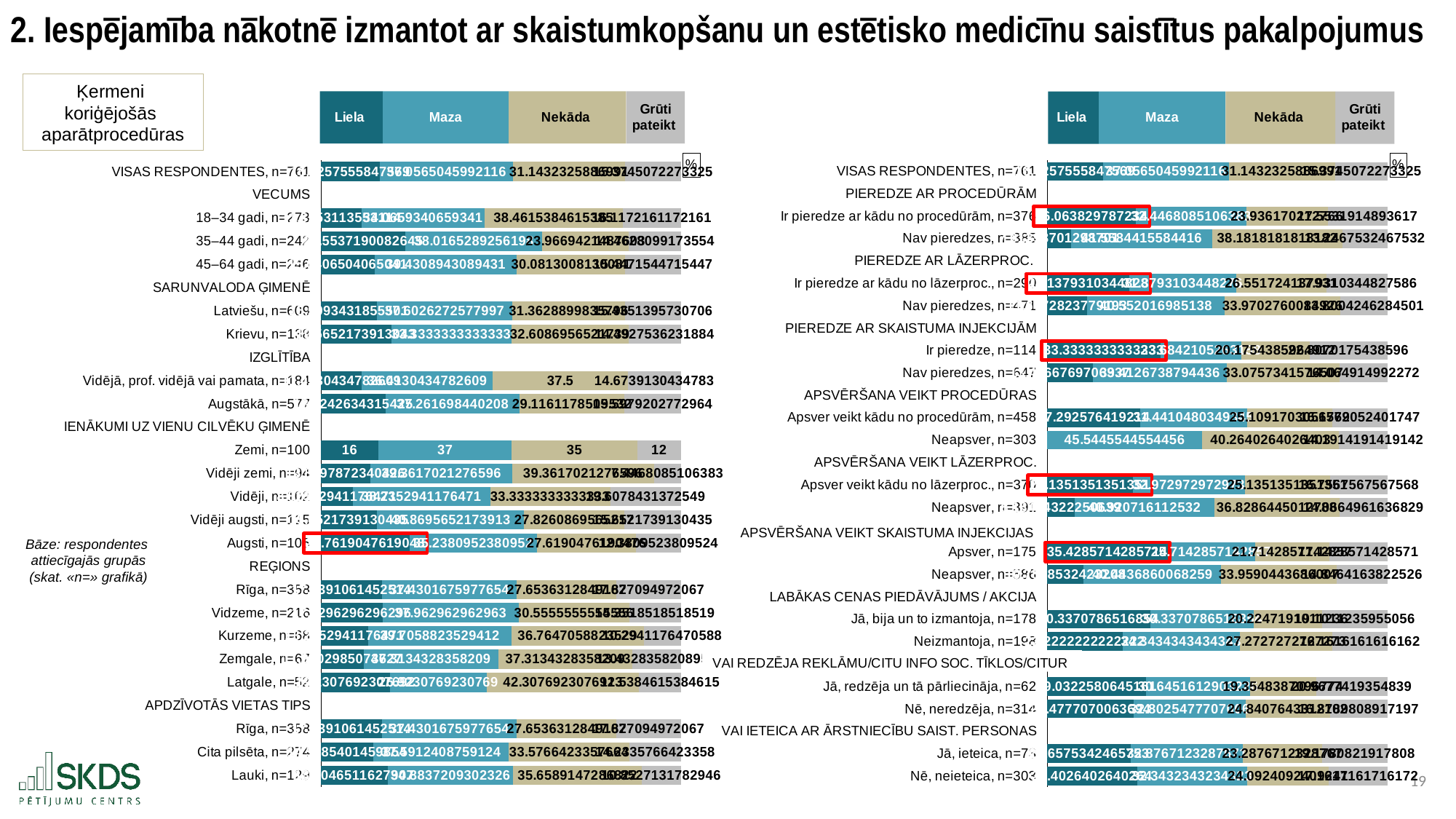
What are the four legend entries of the charts? Liela, Maza, Nekāda, Grūti pateikt In the left chart, what is the value of 'Grūti pateikt' for the row 'Zemi, n=100'? 12 In the left chart, what is the value of 'Nekāda' for the row 'Zemi, n=100'? 35 In the left chart, what is the value of 'Liela' for the row 'Zemi, n=100'? 16 How many series does the legend of the left chart list? 4 What kind of chart is used on the left side of the slide? bar chart In the left chart, what is the difference between 'Maza' and 'Nekāda' in the row 'Zemi, n=100'? 2 In the left chart, which series has the lowest value in the row 'Zemi, n=100'? Grūti pateikt In the left chart, what is the value of 'Maza' for the row 'Zemi, n=100'? 37 In the left chart, which series has the highest value in the row 'Zemi, n=100'? Maza In the left chart, what is the value of 'Nekāda' for the row 'Vidējā, prof. vidējā vai pamata, n=184'? 37.5 In the left chart, what is the total of the stacked bar for 'Zemi, n=100'? 100